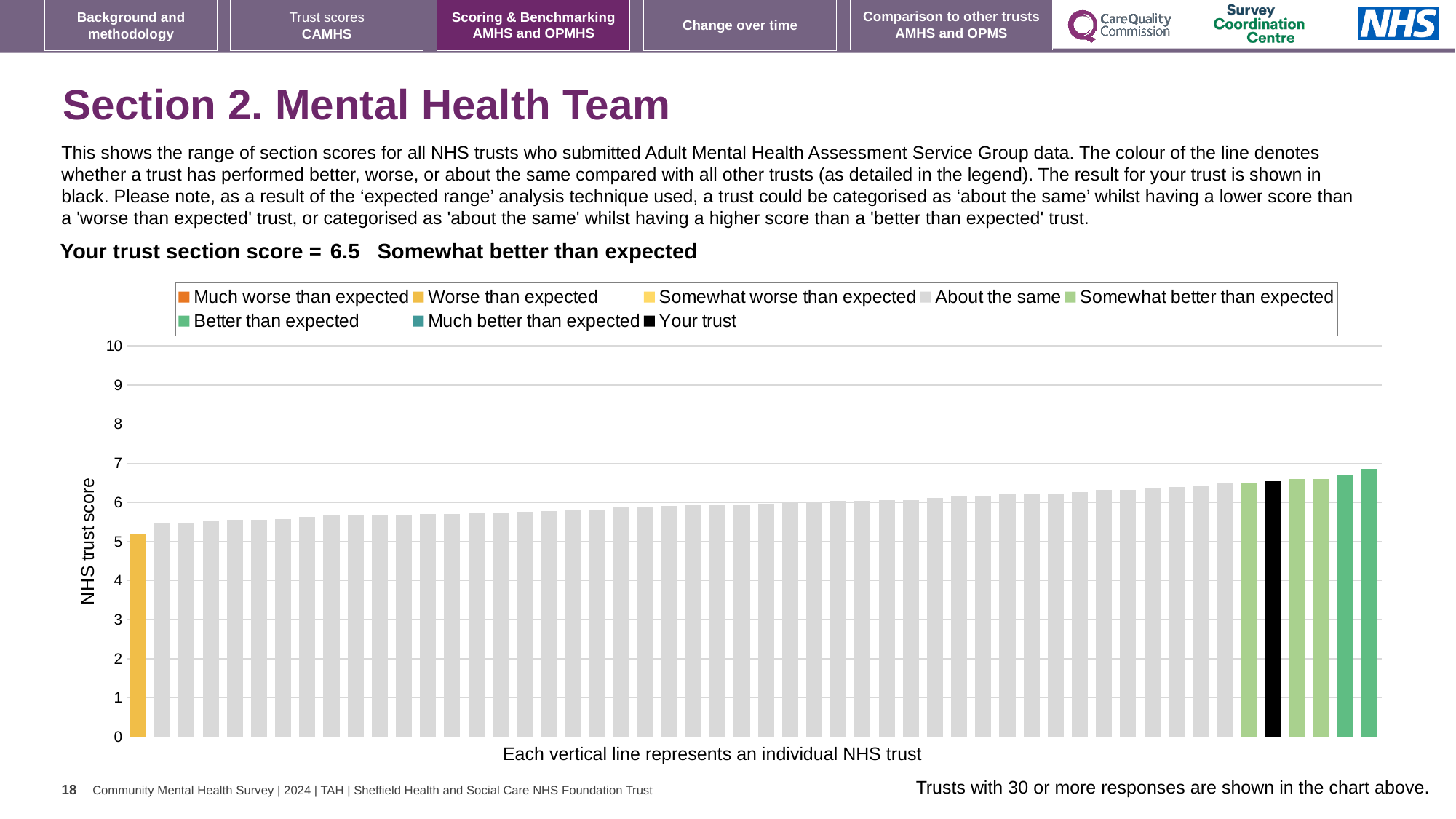
Which is larger: the value for your trust (black bar) or the value of the leftmost yellow bar? your trust Is the value of the leftmost (yellow) bar greater or less than 6? less What is the label on the vertical axis of the chart? NHS trust score What kind of chart is shown on the slide? bar chart What colour is used in the chart for 'Your trust'? black Is the value for your trust (the black bar) greater or less than 6? greater How many entries does the chart legend list? 8 What is the section score for your trust shown on the slide? 6.5 Do the bar values rise or fall from left to right along the x axis? rise Is the value of the tallest bar greater or less than 7? less Which category does your trust's section score fall into, according to the slide? Somewhat better than expected